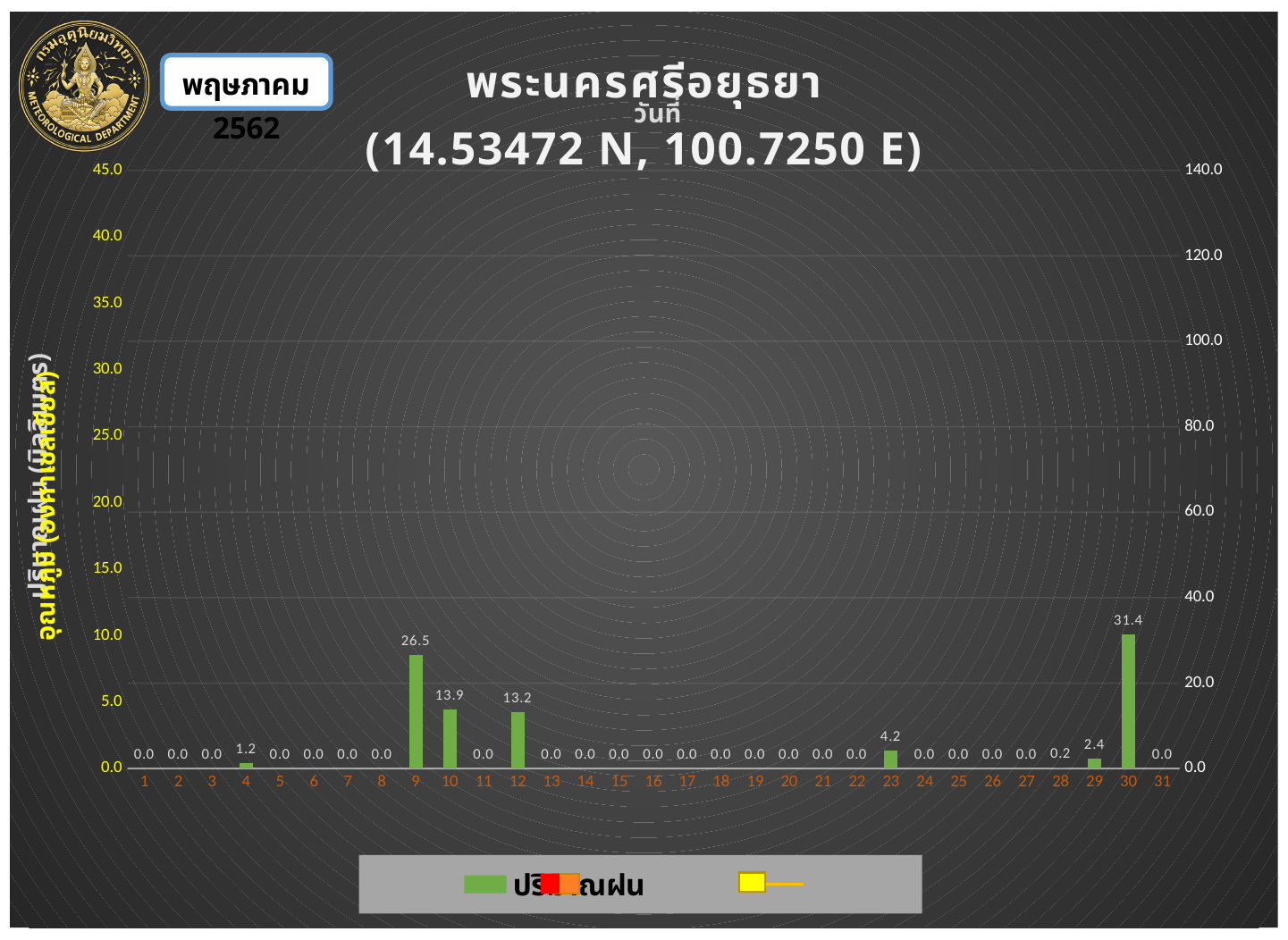
What is the rainfall value shown for day 28? 0.2 What are the coordinates shown in the chart title? 14.53472 N, 100.7250 E What is the rainfall value shown for day 9? 26.5 Which is larger, the rainfall value for day 10 or for day 12? day 10 What is the rainfall value shown for day 30? 31.4 What is the rainfall value shown for day 23? 4.2 Which is larger, the rainfall value for day 4 or for day 29? day 29 How many days are shown on the x axis of the chart? 31 What is the difference between the rainfall values for day 30 and day 9? 4.9 What is the difference between the rainfall values for day 10 and day 12? 0.7 What kind of chart is used to show the rainfall values? bar chart Which day has the highest rainfall value? 30